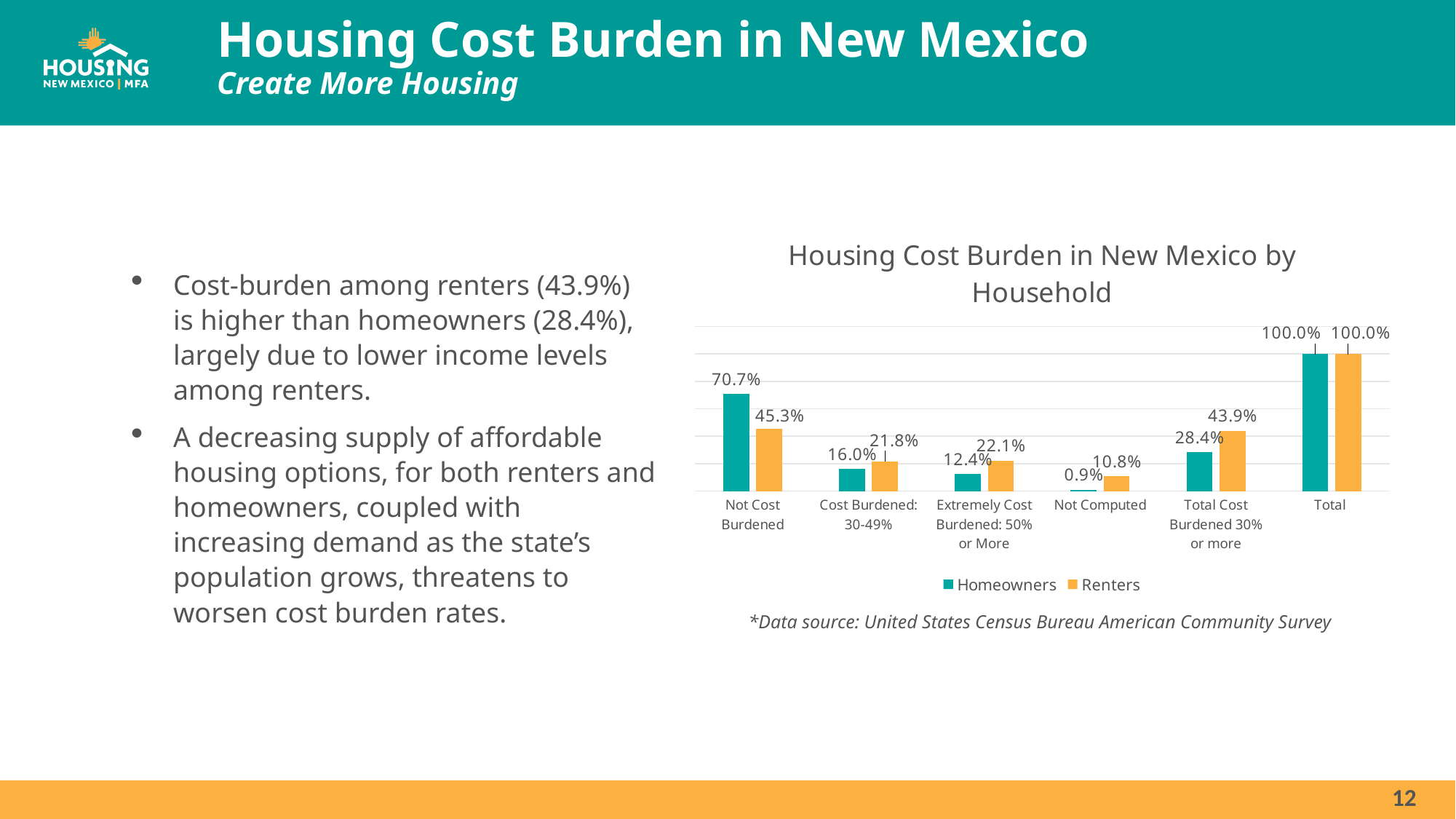
What is the difference between the Renters and Homeowners values for Total Cost Burdened 30% or more? 15.5% What is the difference between the Homeowners and Renters values for Not Cost Burdened? 25.4% How many categories are shown on the x axis? 6 What is the Renters value for Total Cost Burdened 30% or more? 43.9% Which category has the lowest Homeowners value? Not Computed What type of chart is shown on the slide? Bar chart For Cost Burdened: 30-49%, which is larger, the Homeowners value or the Renters value? Renters What is the Homeowners value for Not Cost Burdened? 70.7% What is the Renters value for Extremely Cost Burdened: 50% or More? 22.1% What is the Homeowners value for Not Computed? 0.9% How many series does the legend list? 2 Excluding the Total category, which category has the highest Renters value? Not Cost Burdened